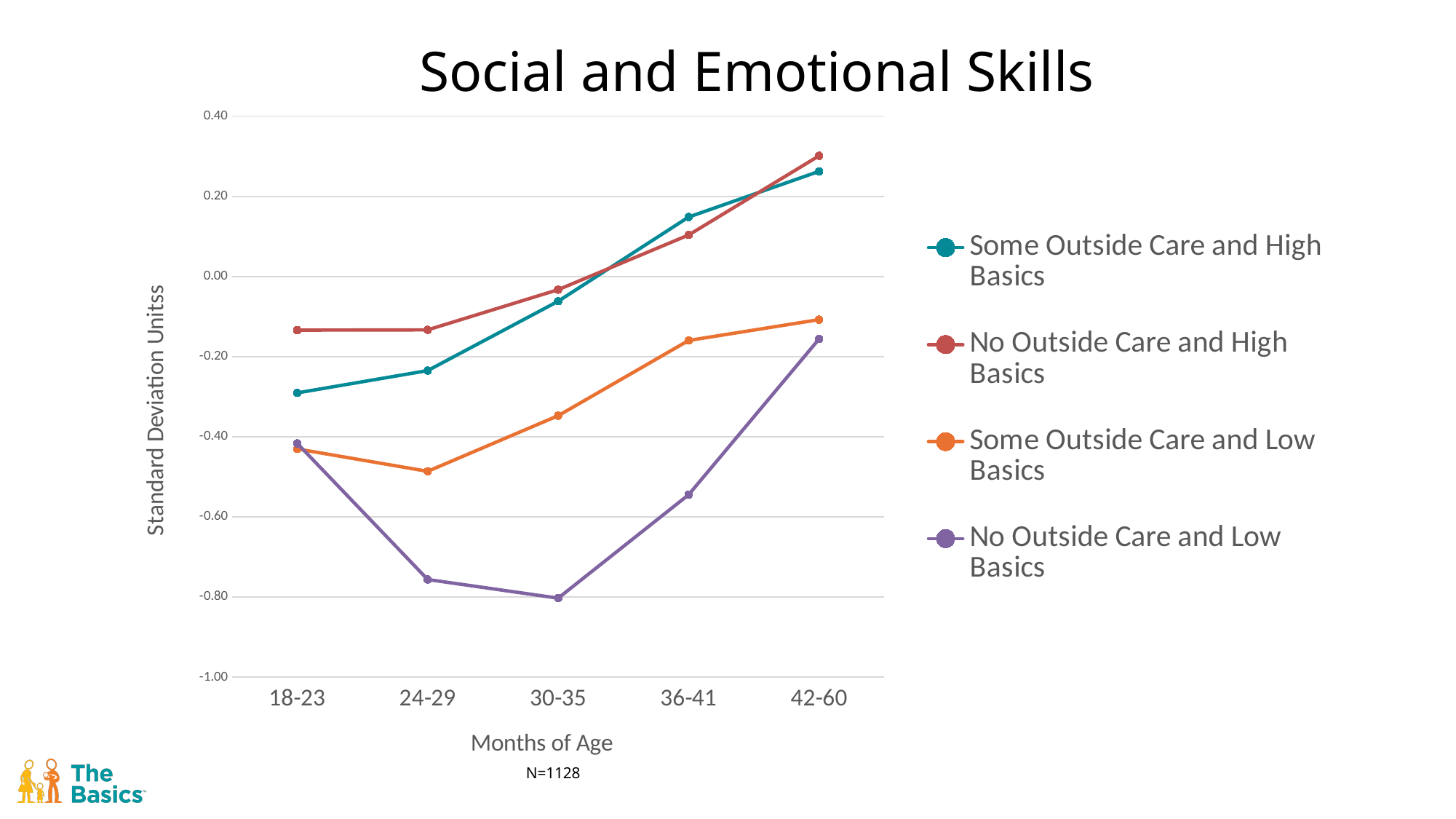
What kind of chart is shown on the slide? line chart Do the values for No Outside Care and Low Basics rise or fall from 18-23 to 30-35 months? fall At 36-41 months, which is larger: Some Outside Care and High Basics or No Outside Care and High Basics? Some Outside Care and High Basics Is the value for Some Outside Care and Low Basics at 24-29 months greater or less than -0.40? less Do the values for Some Outside Care and High Basics rise or fall from 18-23 to 42-60 months? rise Is the value for Some Outside Care and High Basics at 42-60 months greater or less than 0.20? greater How many age categories are shown on the x axis? 5 What is the label on the x axis of the chart? Months of Age Is the value for No Outside Care and Low Basics at 36-41 months greater or less than -0.40? less How many series does the legend list? 4 Which series has the highest value at 42-60 months? No Outside Care and High Basics Which series has the lowest value at 30-35 months? No Outside Care and Low Basics